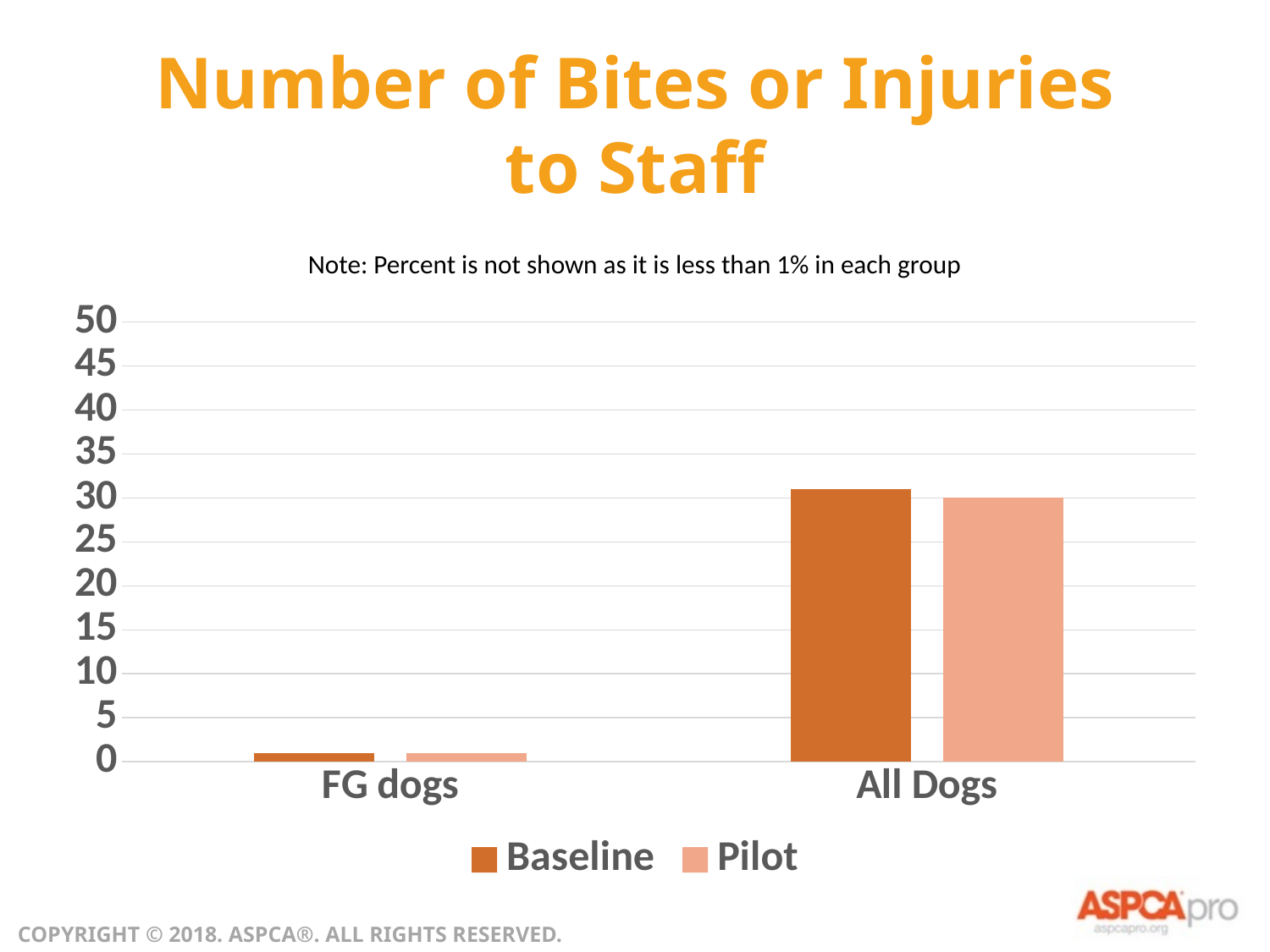
Which is larger, the Pilot value for FG dogs or the Pilot value for All Dogs? All Dogs What kind of chart is shown on the slide? bar chart Is the Pilot value for All Dogs greater or less than 20? greater What is the title of the chart? Number of Bites or Injuries to Staff Which category has the highest Baseline value? All Dogs Which series are listed in the legend? Baseline and Pilot How many categories are shown on the x axis? 2 Is the Baseline value for All Dogs greater or less than 25? greater Is the Pilot value for FG dogs greater or less than 5? less Which category has the lowest Pilot value? FG dogs How many series does the legend list? 2